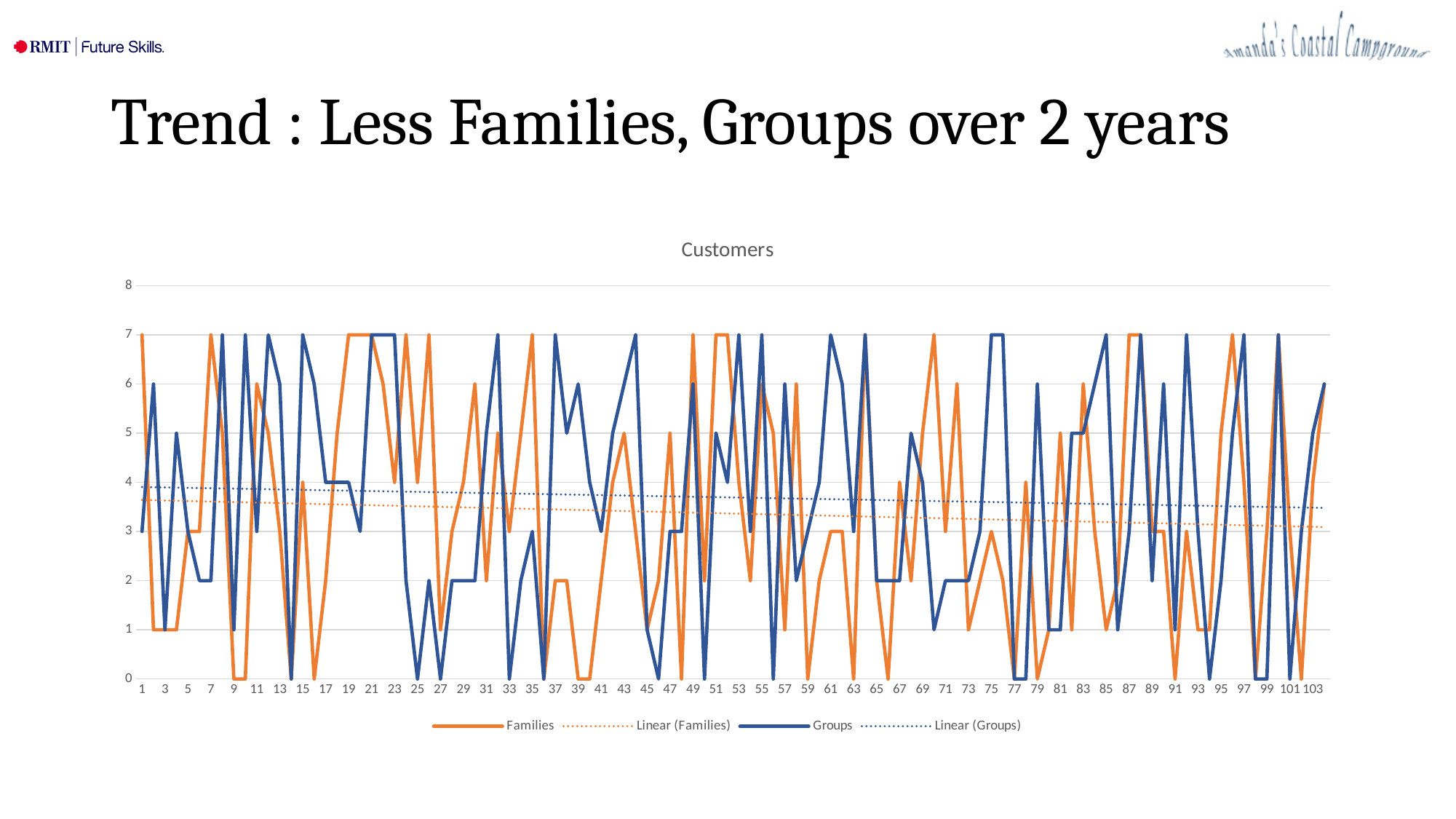
What is the highest value shown on the y axis? 8 Does the Linear (Families) trendline rise or fall from left to right? fall At x = 1, which series has the larger value, Families or Groups? Families What is the Families value at x = 1? 7 How many entries does the chart legend list? 4 What is the title of the chart? Customers Is the Families value at x = 39 greater or less than 2? less What is the Families value at x = 9? 0 What type of chart is shown on the slide? line chart What is the Groups value at x = 77? 0 Is the Families value at x = 1 greater or less than 4? greater What is the last label on the x axis? 103